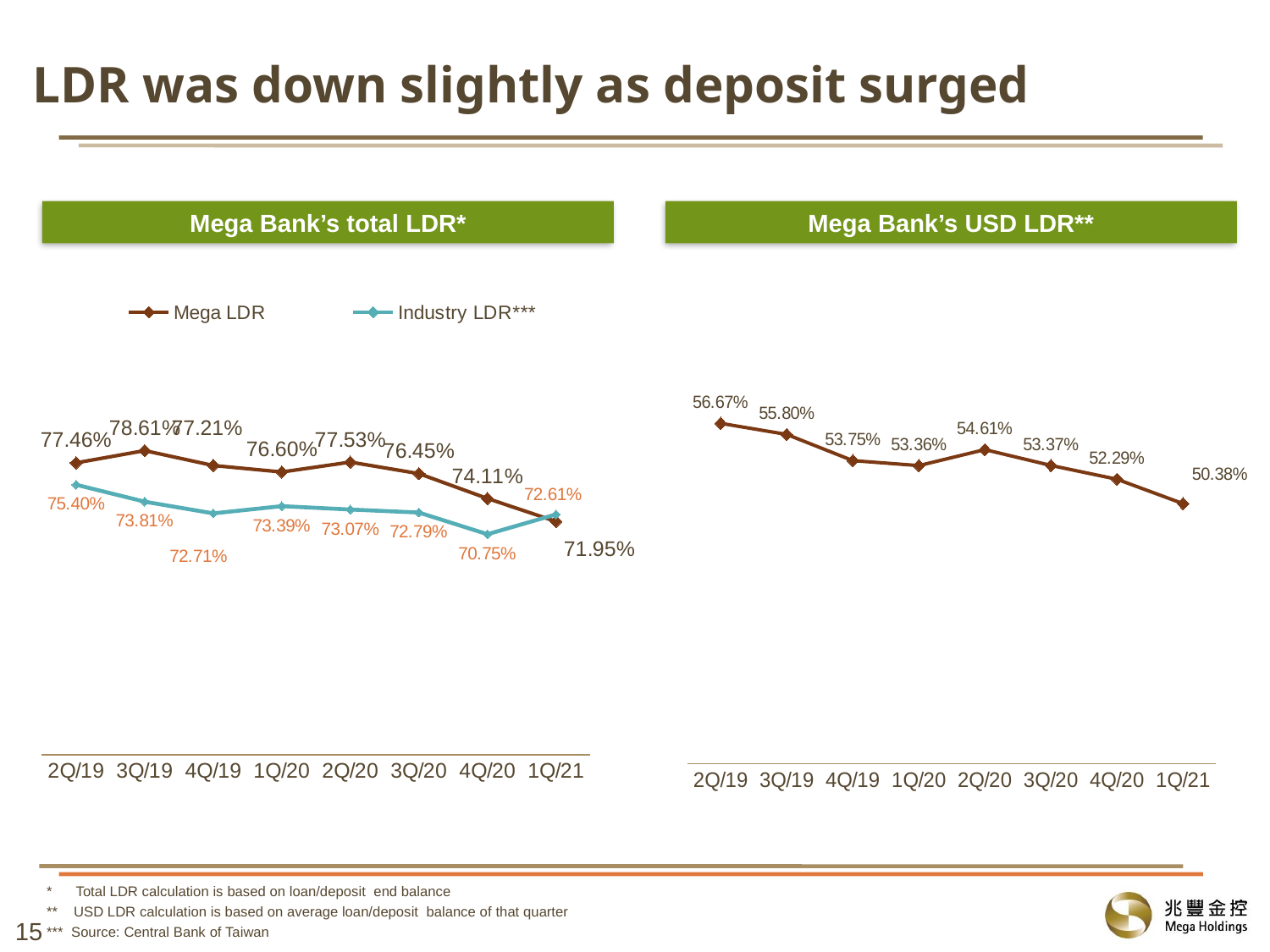
In the Mega Bank's total LDR chart, what is the Mega LDR value for 3Q/19? 78.61% In the Mega Bank's total LDR chart, which is larger in 1Q/21: Mega LDR or Industry LDR? Industry LDR In the Mega Bank's USD LDR chart, what is the value for 2Q/20? 54.61% What kind of chart is the Mega Bank's USD LDR chart? Line chart In the Mega Bank's USD LDR chart, which quarter has the highest value? 2Q/19 In the Mega Bank's USD LDR chart, do the values generally rise or fall from 2Q/19 to 1Q/21? Fall How many series does the legend of the Mega Bank's total LDR chart list? 2 How many quarters are plotted in the Mega Bank's USD LDR chart? 8 In the Mega Bank's total LDR chart, what is the Industry LDR value for 4Q/20? 70.75% In the Mega Bank's USD LDR chart, what is the difference between the 2Q/19 and 1Q/21 values? 6.29% In the Mega Bank's total LDR chart, what is the difference between the Mega LDR and Industry LDR values in 2Q/19? 2.06% In the Mega Bank's total LDR chart, which quarter has the lowest Mega LDR value? 1Q/21